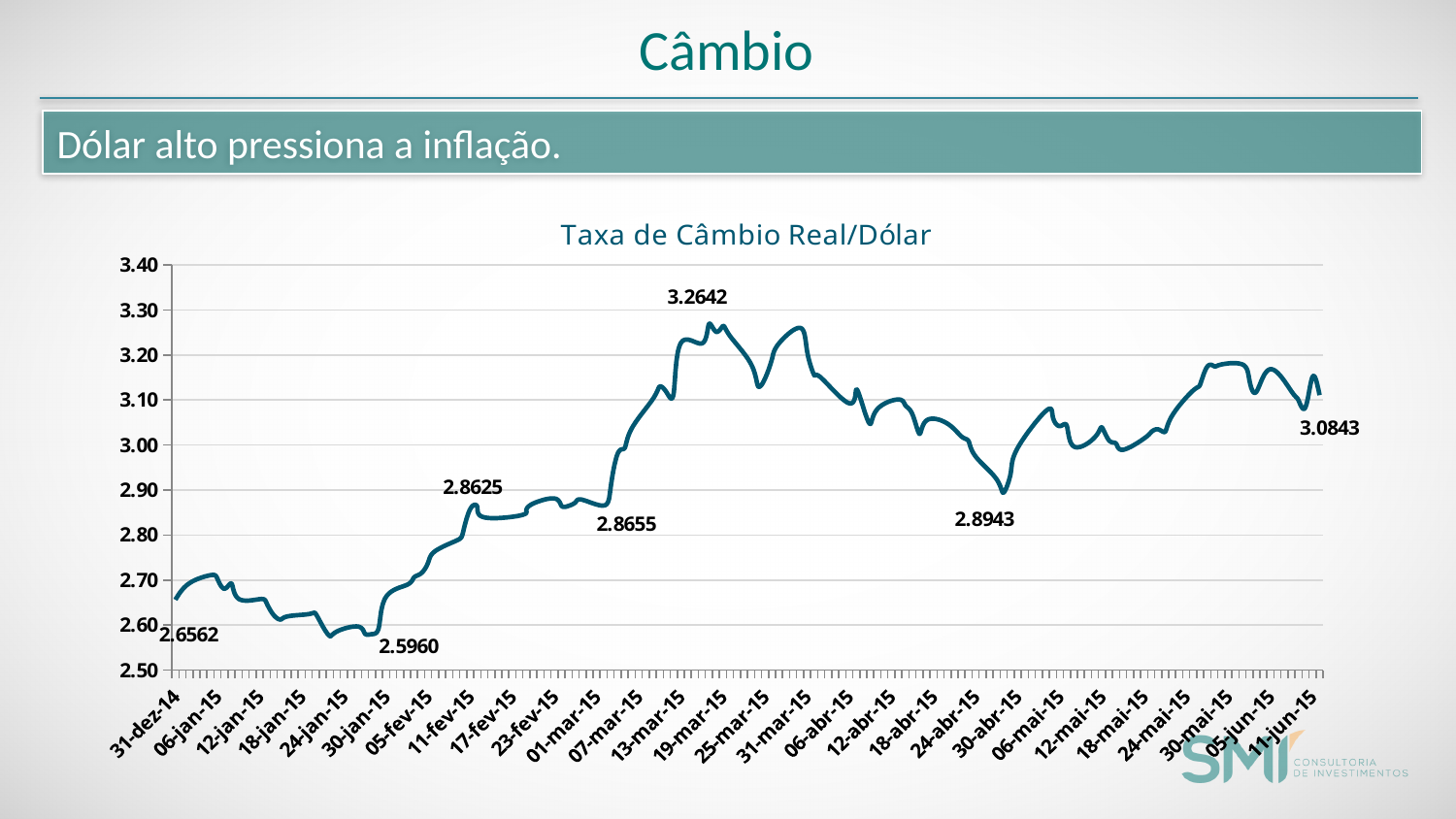
What is the difference between the highest labeled value (3.2642) and the lowest labeled value (2.5960)? 0.6682 What is the labeled value of the last data point (11-jun-15)? 3.0843 What is the difference between the last labeled value (3.0843) and the first labeled value (2.6562)? 0.4281 What is the labeled value of the first data point (31-dez-14)? 2.6562 Is the value on 24-abr-15 greater or less than 3.10? less Which is larger, the labeled value 2.8943 or the labeled value 2.6562? 2.8943 What is the highest labeled value on the chart? 3.2642 What type of chart is shown on the slide? Line chart What is the lowest labeled value on the chart? 2.5960 Overall, does the exchange rate rise or fall from 31-dez-14 to 19-mar-15? rise Is the value on 06-jan-15 greater or less than 2.60? greater What is the title of the chart? Taxa de Câmbio Real/Dólar